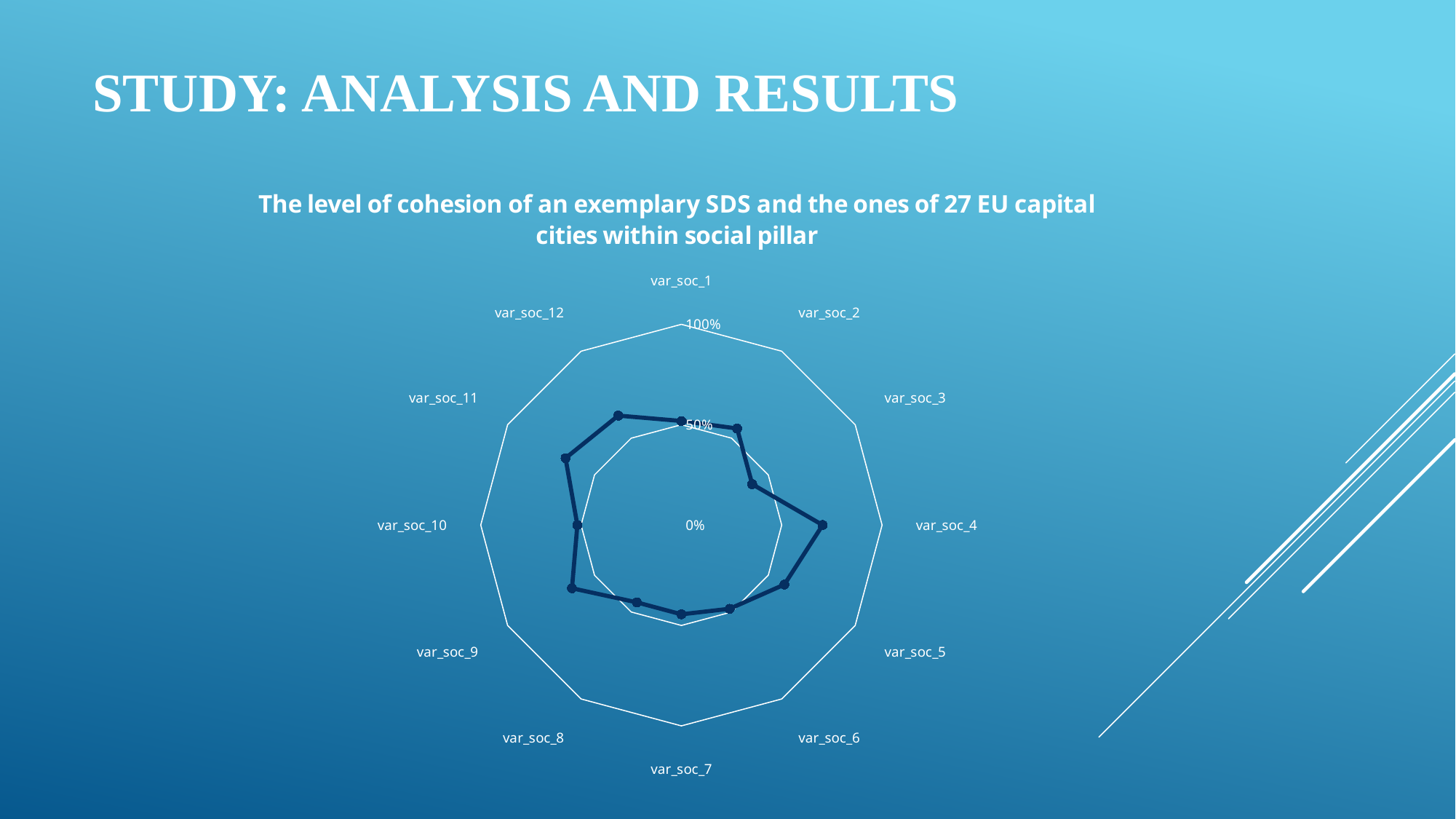
What is the title of the chart? The level of cohesion of an exemplary SDS and the ones of 27 EU capital cities within social pillar Is the value for var_soc_3 greater or less than 50%? less Which has the larger value, var_soc_4 or var_soc_3? var_soc_4 Which has the larger value, var_soc_11 or var_soc_6? var_soc_11 What kind of chart is shown on the slide? Radar chart Is the value for var_soc_11 greater or less than 50%? greater How many categories (variables) are plotted on the radar chart? 12 Is the value for var_soc_9 greater or less than 50%? greater What is the maximum value shown on the chart's axis scale? 100% Which category has the lowest value on the radar chart? var_soc_3